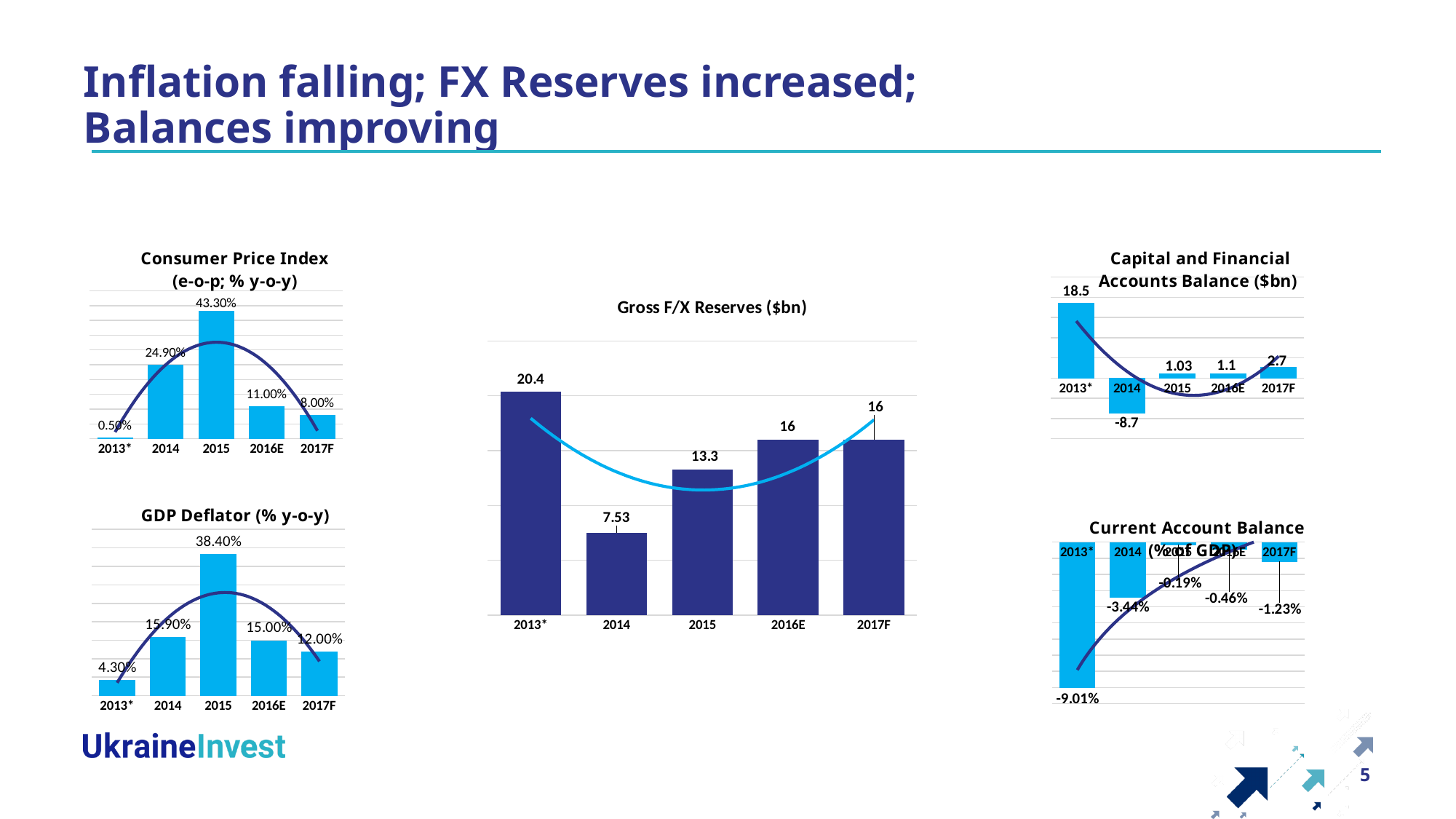
In the Consumer Price Index chart, which year has the highest value? 2015 What kind of chart is the Gross F/X Reserves chart? bar chart In the Capital and Financial Accounts Balance chart, what is the value for 2014? -8.7 How many years are shown in the Gross F/X Reserves chart? 5 In the GDP Deflator chart, what is the value for 2013*? 4.30% In the Current Account Balance chart, what is the value for 2013*? -9.01% In the Current Account Balance chart, which is higher, the value for 2014 or the value for 2016E? 2016E In the GDP Deflator chart, what is the difference between the 2015 and 2016E values? 23.40 percentage points In the Gross F/X Reserves chart, what is the value for 2014? 7.53 In the Consumer Price Index chart, what is the value for 2015? 43.30% In the Gross F/X Reserves chart, which year has the lowest value? 2014 In the Capital and Financial Accounts Balance chart, what is the difference between the 2013* and 2014 values? 27.2